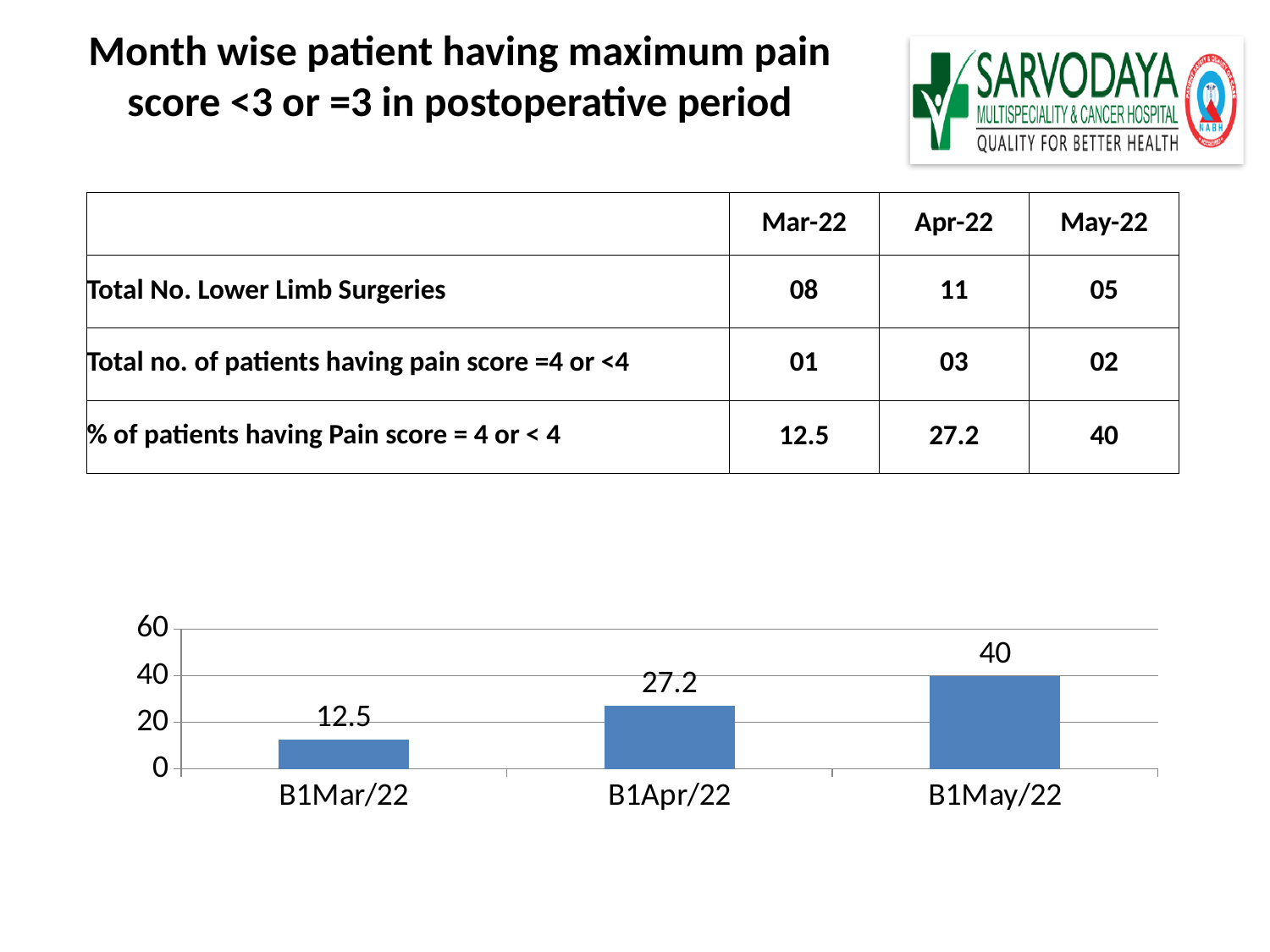
Which category has the highest value in the bar chart? B1May/22 Which category has the lowest value in the bar chart? B1Mar/22 Which is larger, the value for B1Apr/22 or B1Mar/22? B1Apr/22 What is the difference between the values for B1May/22 and B1Mar/22? 27.5 What kind of chart is shown on the slide? bar chart What is the value for B1Apr/22 in the bar chart? 27.2 What is the difference between the values for B1Apr/22 and B1Mar/22? 14.7 Do the values rise or fall from B1Mar/22 to B1May/22? rise How many categories are shown in the bar chart? 3 Is the value for B1Apr/22 greater or less than 20? greater What is the value for B1Mar/22 in the bar chart? 12.5 What is the value for B1May/22 in the bar chart? 40